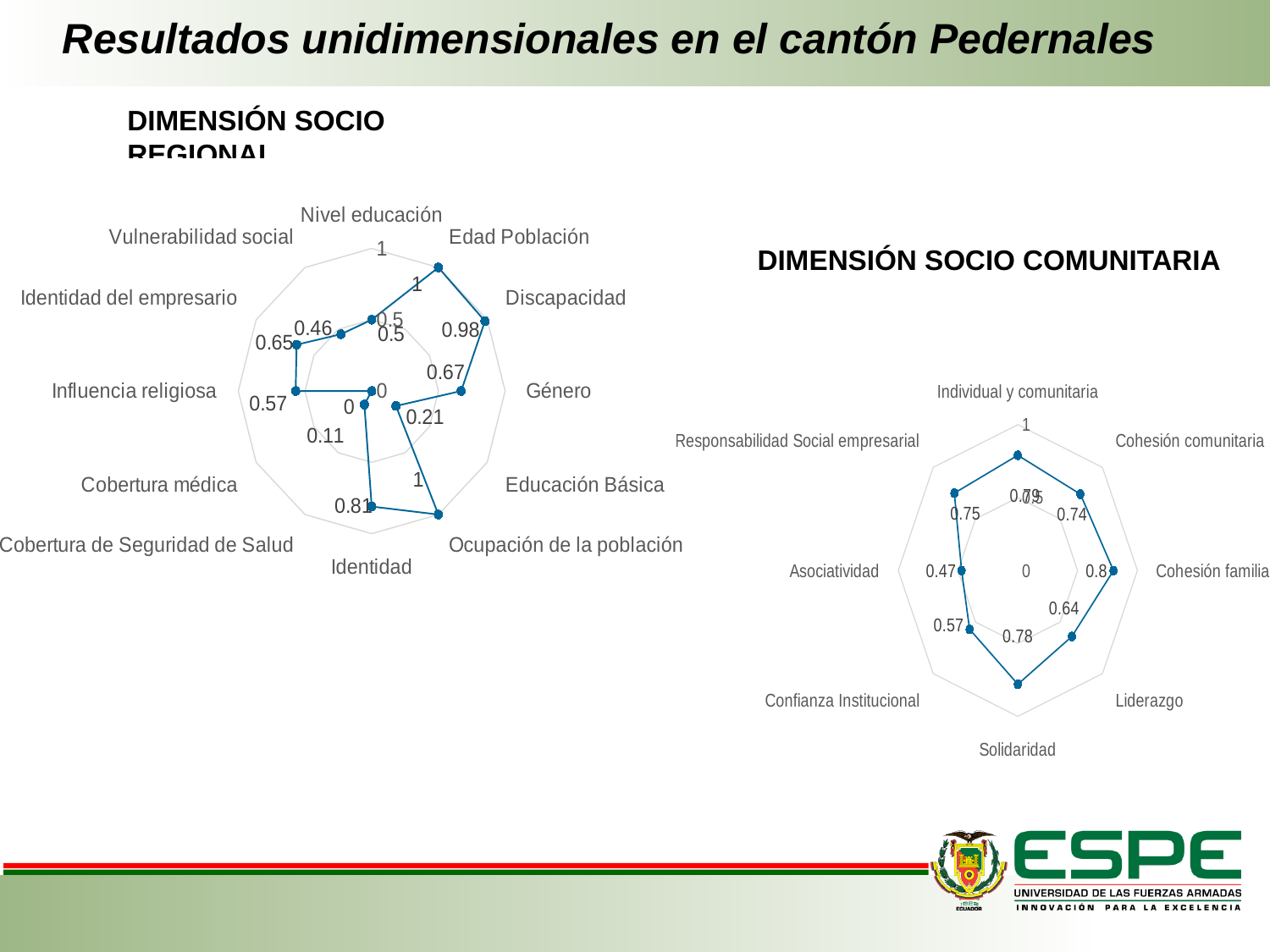
In the right chart (DIMENSIÓN SOCIO COMUNITARIA), what is the value for Asociatividad? 0.47 In the right chart (DIMENSIÓN SOCIO COMUNITARIA), which category has the lowest value? Asociatividad In the left chart (DIMENSIÓN SOCIO REGIONAL), what is the value for Género? 0.67 In the right chart (DIMENSIÓN SOCIO COMUNITARIA), what is the difference between the values for Solidaridad and Confianza Institucional? 0.21 What kind of chart is the right chart (DIMENSIÓN SOCIO COMUNITARIA)? Radar chart In the left chart (DIMENSIÓN SOCIO REGIONAL), what is the value for Discapacidad? 0.98 How many categories does the right chart (DIMENSIÓN SOCIO COMUNITARIA) have? 8 In the left chart (DIMENSIÓN SOCIO REGIONAL), what is the value for Influencia religiosa? 0.57 How many categories does the left chart (DIMENSIÓN SOCIO REGIONAL) have? 12 In the left chart (DIMENSIÓN SOCIO REGIONAL), which is larger, the value for Discapacidad or the value for Educación Básica? Discapacidad In the right chart (DIMENSIÓN SOCIO COMUNITARIA), what is the value for Cohesión familia? 0.8 In the right chart (DIMENSIÓN SOCIO COMUNITARIA), what is the value for Liderazgo? 0.64